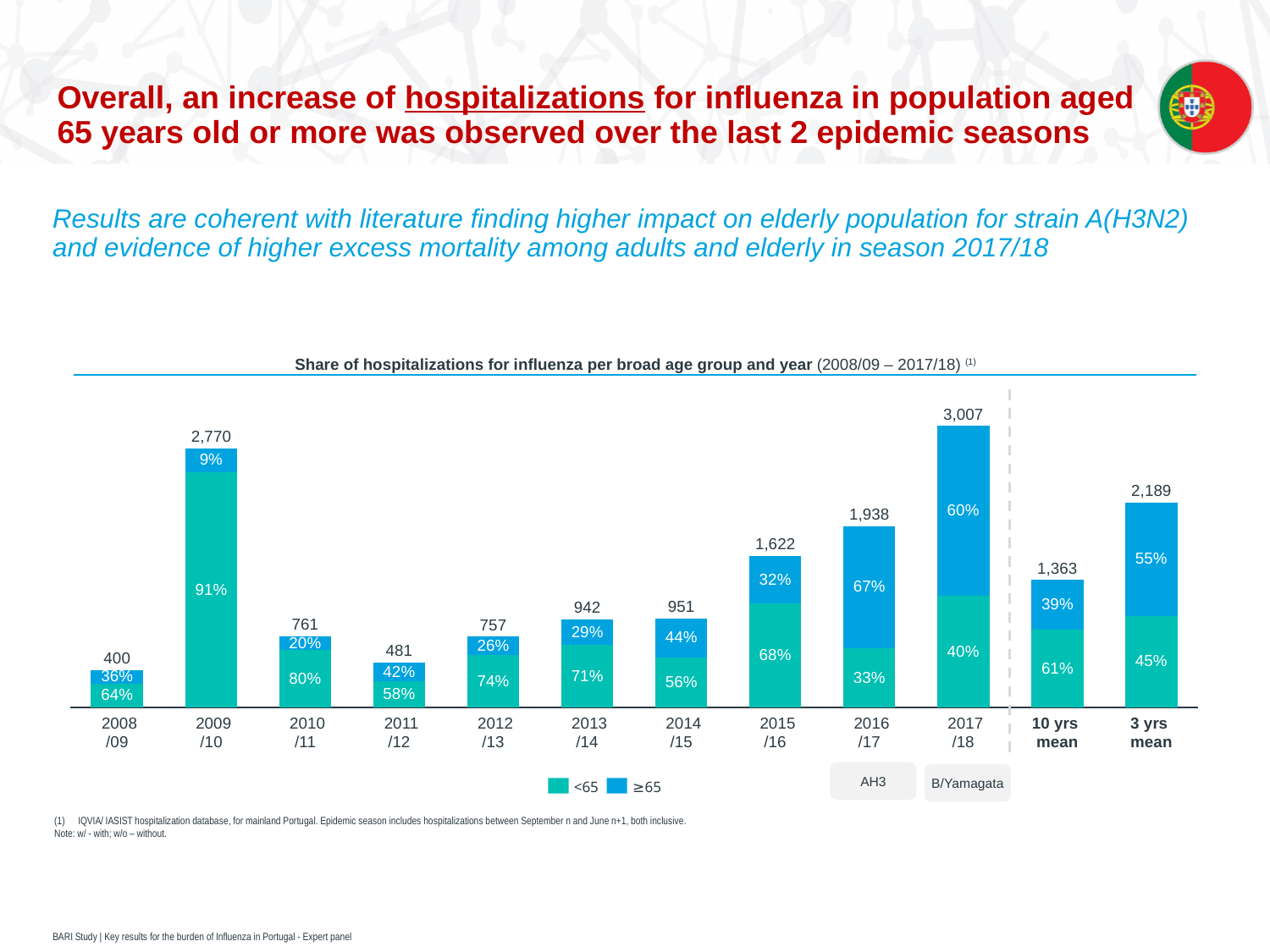
What are the two age groups listed in the legend? <65 and ≥65 What share of hospitalizations in 2009/10 was in the ≥65 age group? 9% How many series does the legend list? 2 What type of chart is used to show the share of hospitalizations per age group and year? Stacked bar chart What share of hospitalizations in 2016/17 was in the <65 age group? 33% Which epidemic season has the highest total number of hospitalizations? 2017/18 What is the 10 yrs mean total of hospitalizations shown on the chart? 1,363 How many epidemic seasons (excluding the mean bars) are plotted on the chart? 10 Which season has a larger total of hospitalizations, 2013/14 or 2014/15? 2014/15 Which epidemic season has the lowest total number of hospitalizations? 2008/09 What is the difference between the total hospitalizations in 2017/18 and 2016/17? 1,069 What is the total number of hospitalizations shown for the 2017/18 season? 3,007